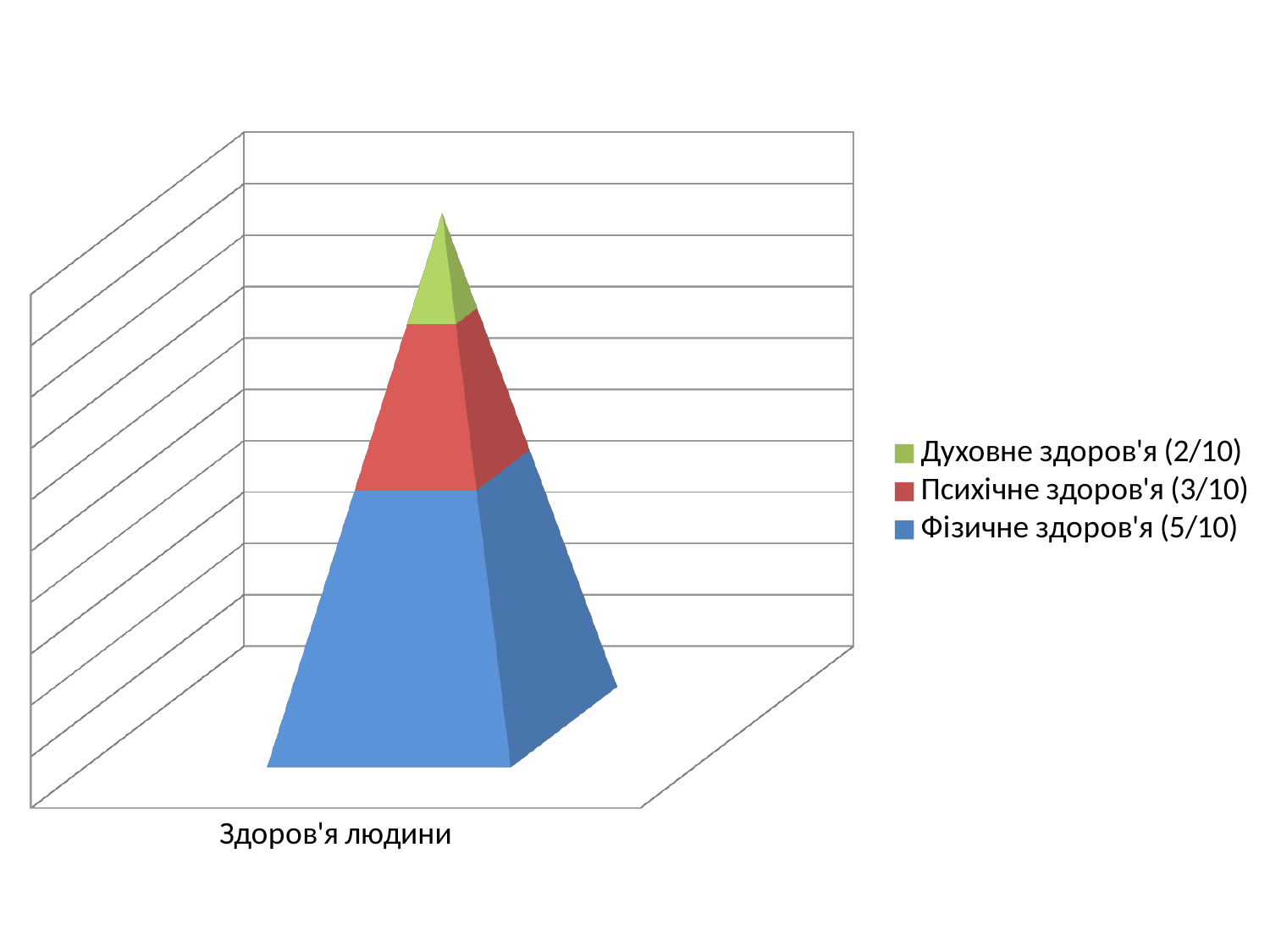
What is the difference between the values for Фізичне здоров'я and Духовне здоров'я shown in the legend? 3/10 Which series occupies the largest segment of the stacked pyramid? Фізичне здоров'я (5/10) What is the label of the single category on the x axis? Здоров'я людини According to the legend, what value is given for Духовне здоров'я? 2/10 Which series occupies the smallest segment of the stacked pyramid? Духовне здоров'я (2/10) How many series does the legend list? 3 Which colour represents Психічне здоров'я in the legend? Red According to the legend, what value is given for Фізичне здоров'я? 5/10 What is the total of the three values shown in the legend for the stacked pyramid? 10/10 According to the legend, what value is given for Психічне здоров'я? 3/10 How many categories are shown on the x axis? 1 Which is larger, the segment for Психічне здоров'я or the segment for Духовне здоров'я? Психічне здоров'я